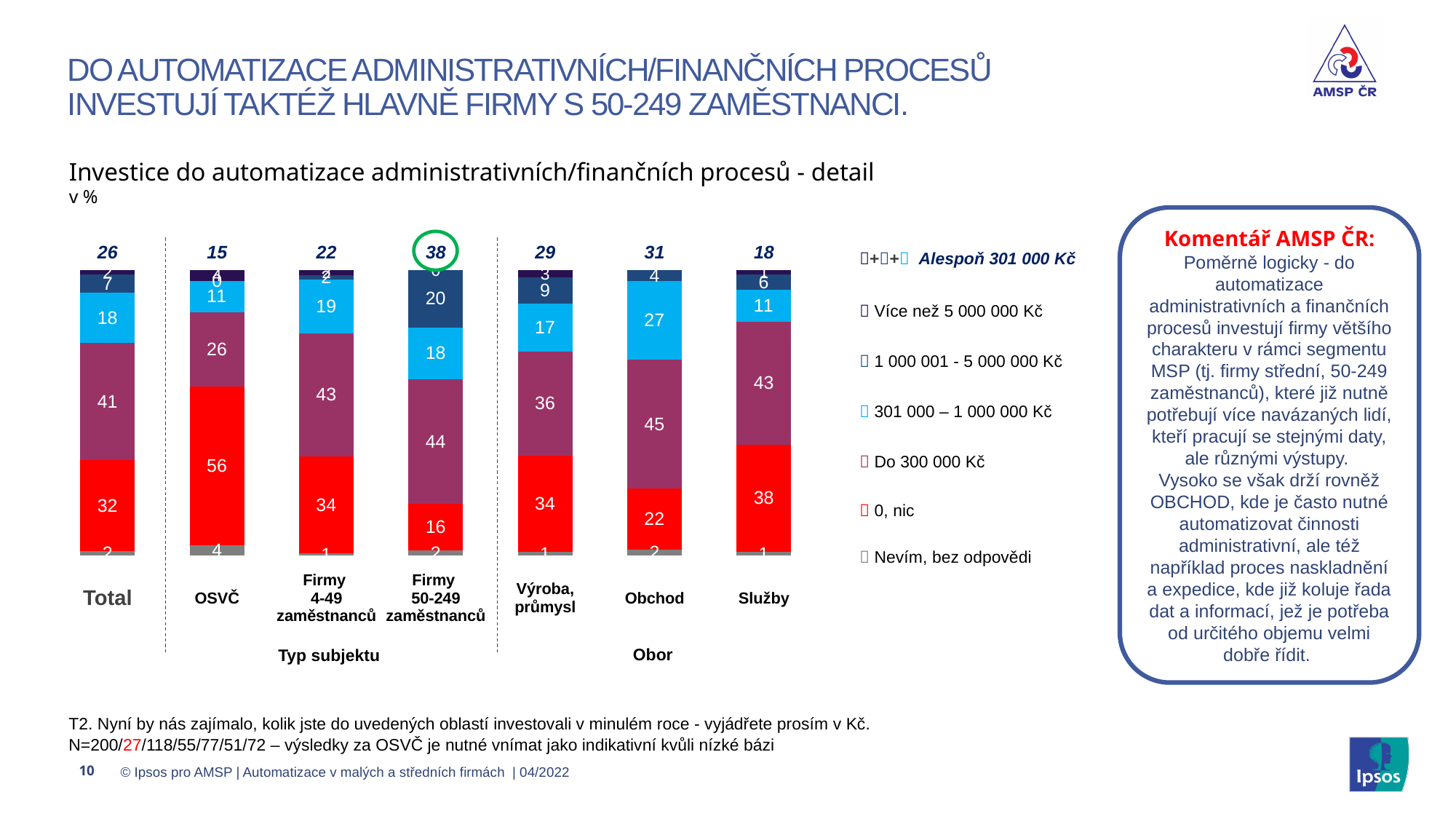
What percentage of Obchod respondents invested 301 000 – 1 000 000 Kč? 27 Which category has the highest 'Alespoň 301 000 Kč' value? Firmy 50-249 zaměstnanců Which has a larger share of respondents investing 0, nic: Výroba, průmysl or Obchod? Výroba, průmysl Which category has the lowest 'Alespoň 301 000 Kč' value? OSVČ What percentage of Služby respondents invested Do 300 000 Kč? 43 What is the difference between the 'Alespoň 301 000 Kč' values for Obchod and Služby? 13 What percentage of OSVČ respondents invested 0, nic (nothing)? 56 How many bars (categories) are shown in the chart? 7 What is the 'Alespoň 301 000 Kč' value for the Total bar? 26 How many investment ranges (excluding the combined 'Alespoň 301 000 Kč' line) does the legend list? 6 What type of chart is shown on the slide? Stacked bar chart What is the 'Alespoň 301 000 Kč' value shown above the bar for Firmy 50-249 zaměstnanců? 38